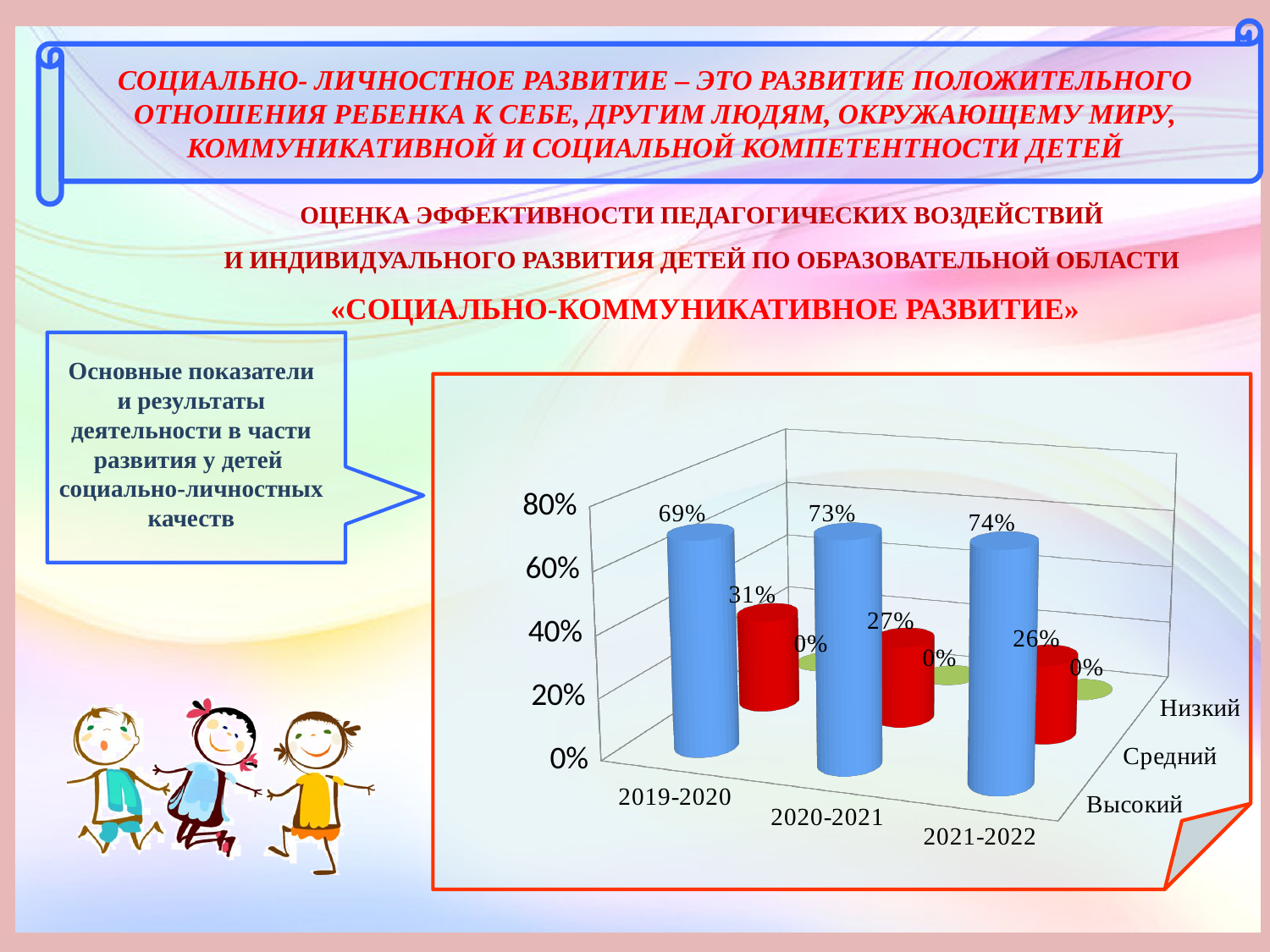
What is the value for Средний in 2020-2021? 27% Which is larger in 2019-2020: the value for Высокий or the value for Средний? Высокий How many series (levels) does the chart show? 3 How many periods are shown on the x axis? 3 What is the value for Высокий in 2021-2022? 74% What is the difference between the Высокий values for 2021-2022 and 2019-2020? 5% What is the value for Высокий in 2019-2020? 69% What kind of chart is shown on the slide? bar chart What is the value for Низкий in 2019-2020? 0% In which period is the value for Средний the lowest? 2021-2022 Do the values for Средний rise or fall from 2019-2020 to 2021-2022? fall In which period is the value for Высокий the highest? 2021-2022